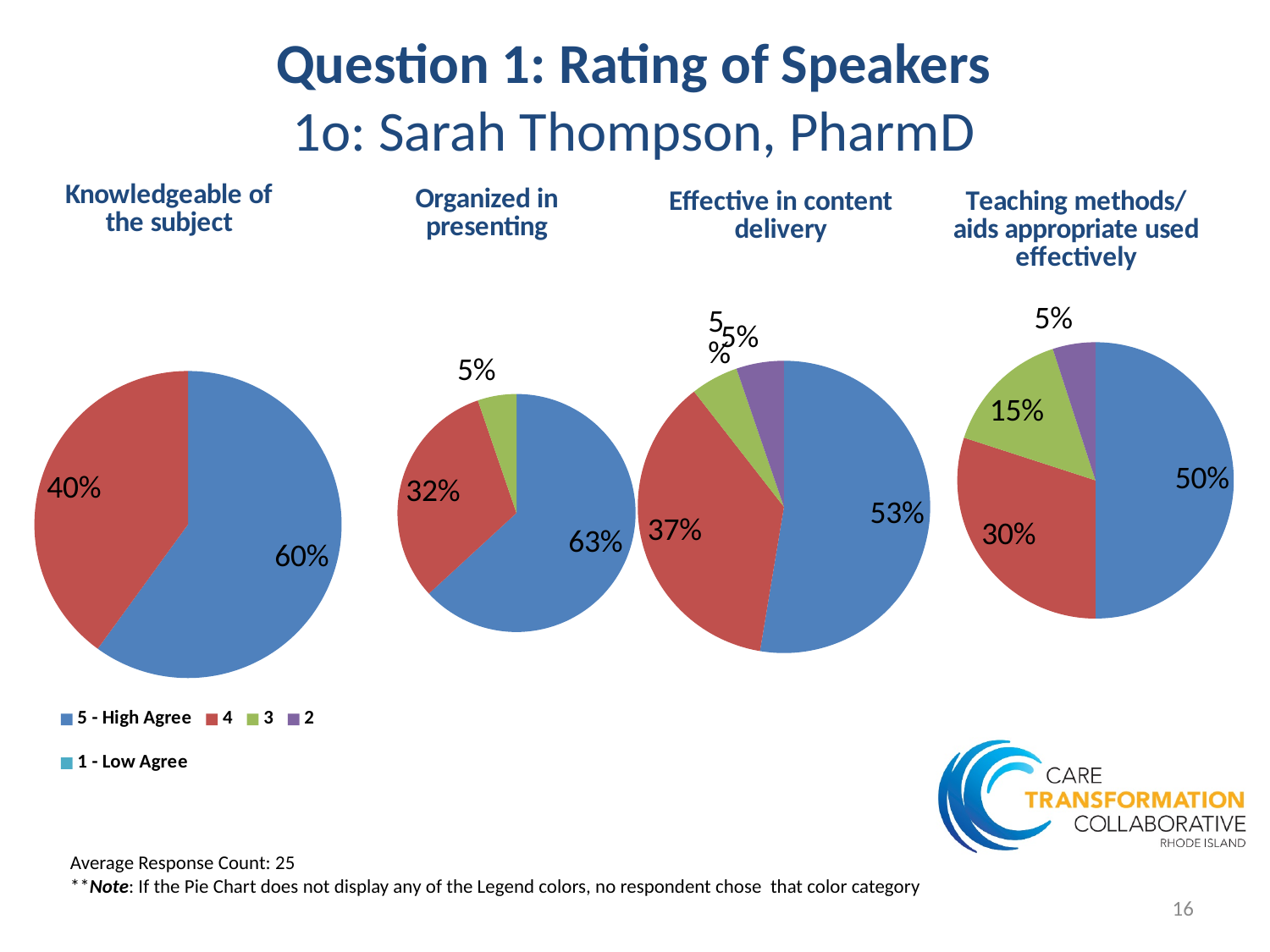
How many slices does the 'Knowledgeable of the subject' pie chart have? 2 In the 'Organized in presenting' pie chart, what share of respondents chose '5 - High Agree'? 63% In the 'Knowledgeable of the subject' pie chart, what share of respondents chose '4'? 40% In the 'Organized in presenting' pie chart, what is the difference between the '5 - High Agree' share and the '4' share? 31% In the 'Teaching methods/aids appropriate used effectively' pie chart, what share of respondents chose '3'? 15% How many entries does the legend list? 5 In the 'Teaching methods/aids appropriate used effectively' pie chart, which rating has the largest slice? 5 - High Agree What kind of chart is used for 'Effective in content delivery'? Pie chart